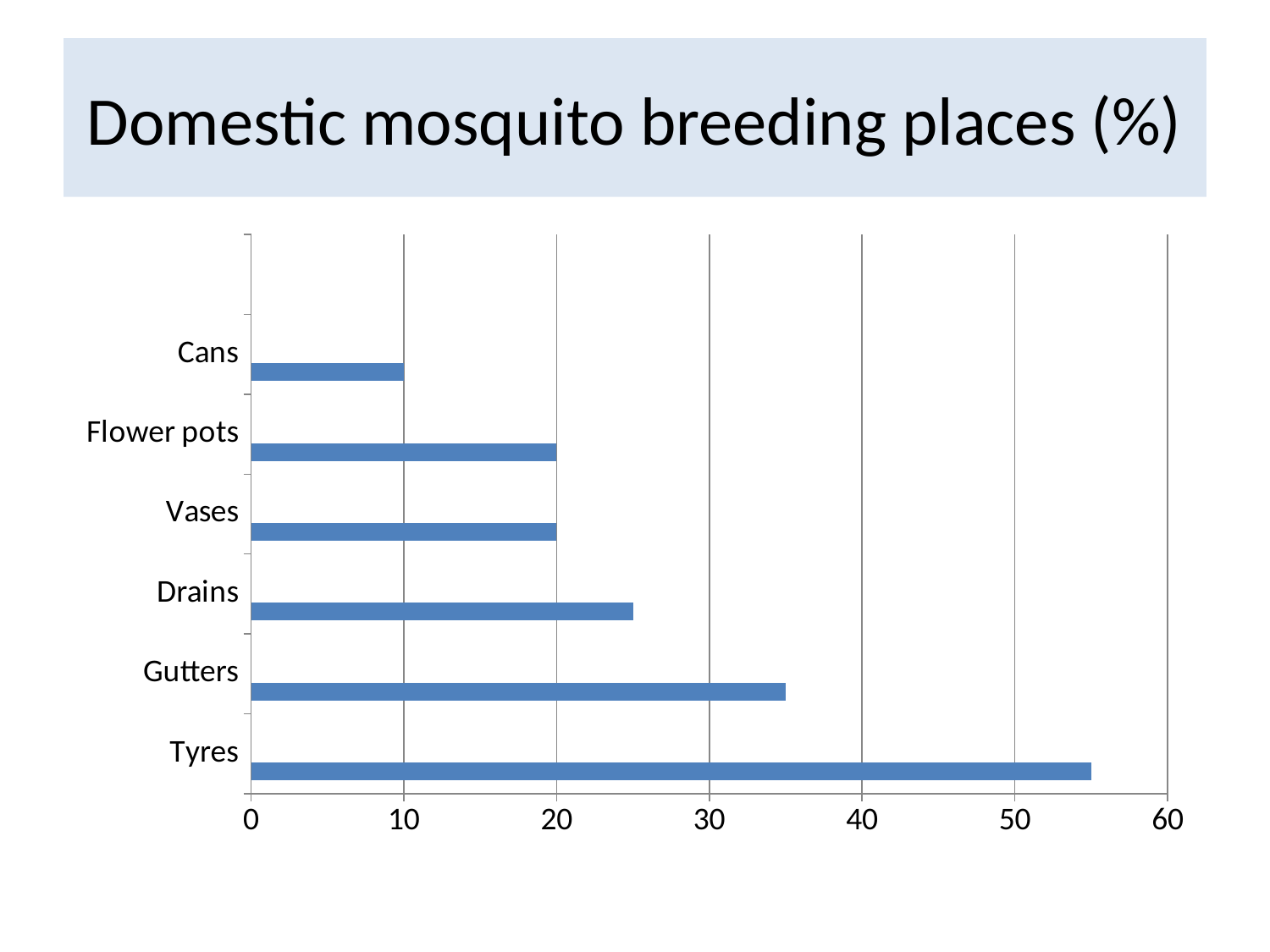
What is the title of the chart? Domestic mosquito breeding places (%) Which category has the highest value? Tyres What kind of chart is shown on the slide? bar chart What is the value for Flower pots? 20 How many categories are plotted in the chart? 6 What is the difference between the values for Flower pots and Cans? 10 Which category has the lowest value? Cans What is the value for Vases? 20 Is the value for Tyres greater or less than 50? greater Which is larger, the value for Gutters or the value for Drains? Gutters Is the value for Gutters greater or less than 40? less What is the value for Cans? 10